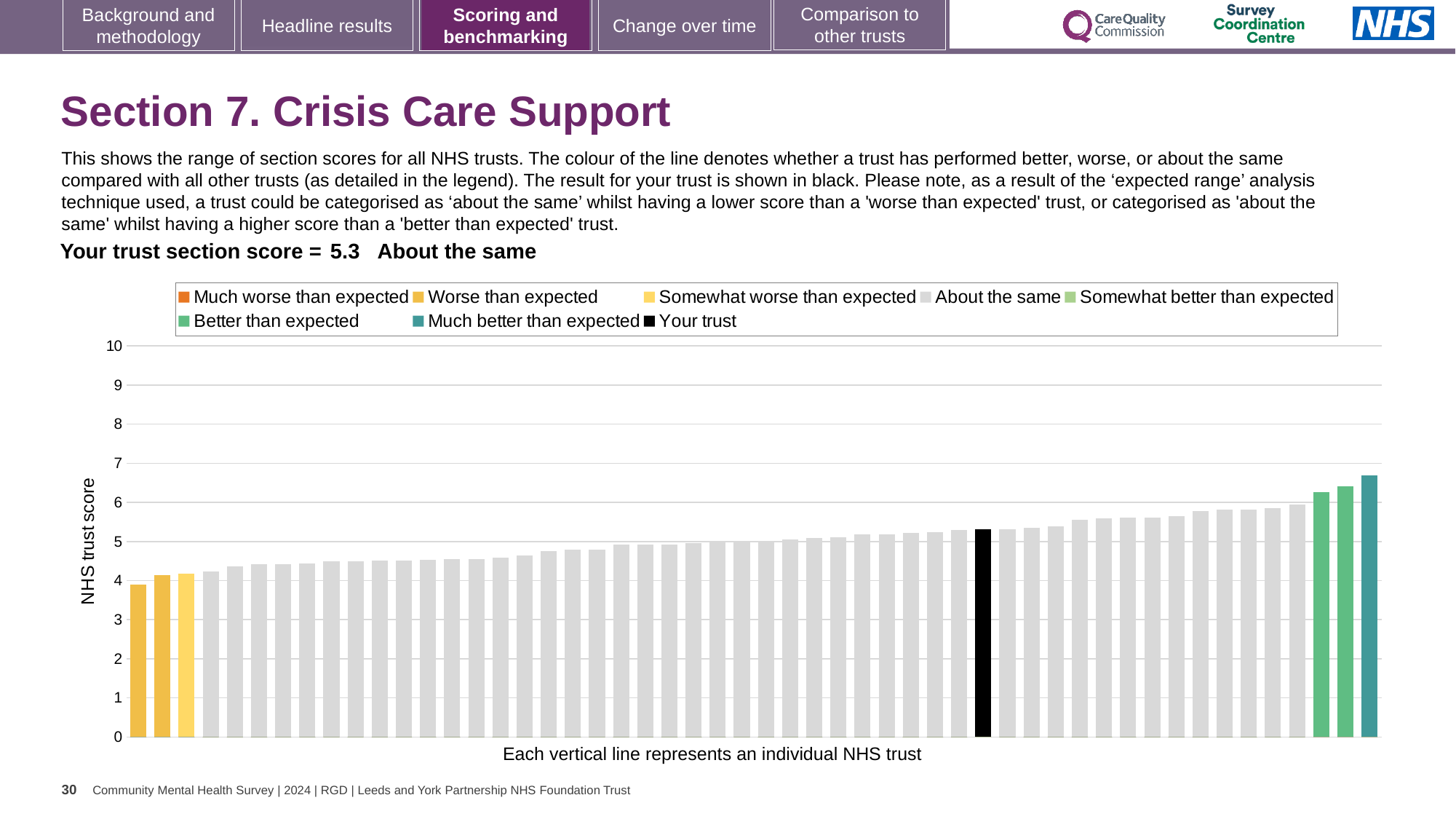
Is the score of the lowest trust greater or less than 5? less How many entries does the chart legend list? 8 Do the trust scores rise or fall from left to right along the x axis? rise What colour is the bar representing your trust? black What kind of chart is shown on the slide? bar chart How is your trust's performance categorised for Section 7 Crisis Care Support? About the same How many trusts are shown in the 'Much better than expected' colour? 1 What is the label on the vertical axis of the chart? NHS trust score Is your trust's section score greater or less than 5? greater Which is larger: the score of the rightmost trust or your trust's score? the rightmost trust Is the score of the highest trust greater or less than 6? greater What is the section score for your trust shown on the slide? 5.3